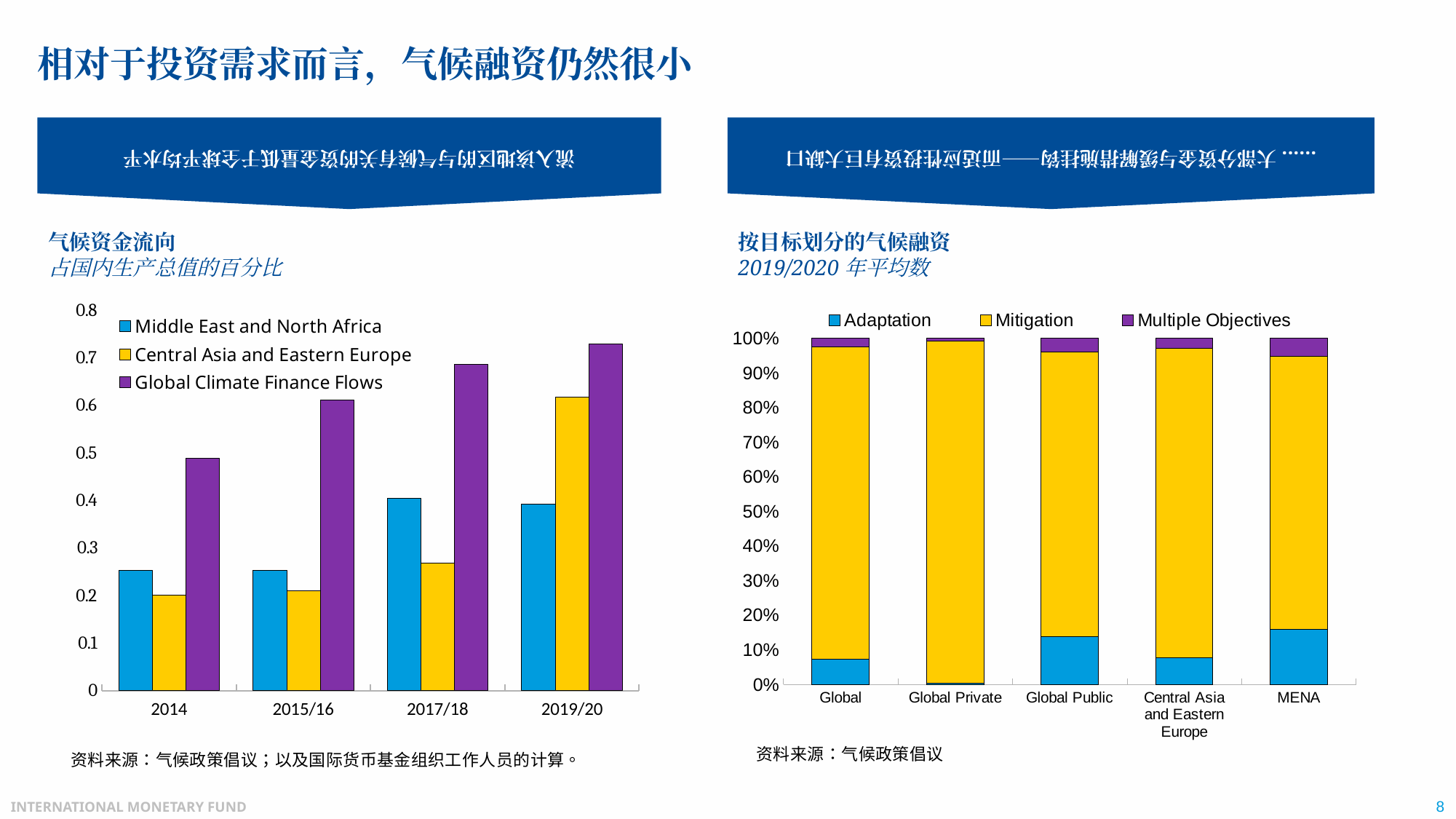
In the right chart (按目标划分的气候融资), is the Mitigation share for Global Private greater or less than 90%? greater In the left chart (气候资金流向), does the Global Climate Finance Flows series rise or fall from 2014 to 2019/20? rise In the right chart (按目标划分的气候融资), how many categories are shown on the x axis? 5 In the left chart (气候资金流向), what kind of chart is shown? bar chart In the left chart (气候资金流向), how many time periods are shown on the x axis? 4 In the left chart (气候资金流向), which is larger in 2017/18: Middle East and North Africa or Central Asia and Eastern Europe? Middle East and North Africa In the left chart (气候资金流向), is the value for Central Asia and Eastern Europe in 2019/20 greater or less than 0.5? greater In the left chart (气候资金流向), in which period is Global Climate Finance Flows highest? 2019/20 In the left chart (气候资金流向), is the value for Middle East and North Africa in 2014 greater or less than 0.3? less In the right chart (按目标划分的气候融资), which category has the largest Adaptation share? MENA In the left chart (气候资金流向), how many series does the legend list? 3 In the right chart (按目标划分的气候融资), how many series does the legend list? 3